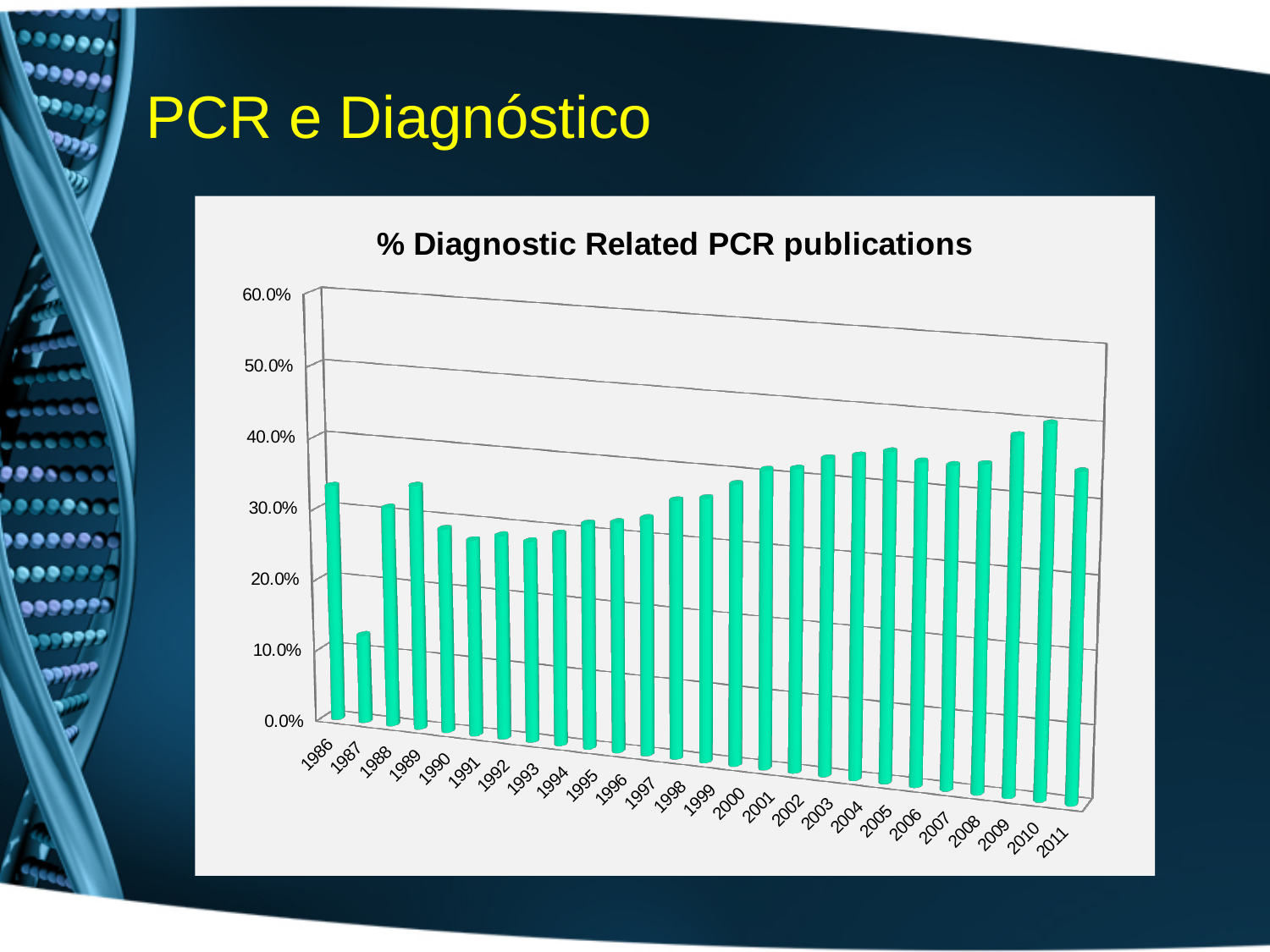
What is the title of the chart? % Diagnostic Related PCR publications Is the value for 2005 greater or less than 30.0%? greater Do the values generally rise or fall from 1991 to 2005? rise Which year has the lowest value in the chart? 1987 Which year has the larger value, 1991 or 2005? 2005 How many years are plotted on the x axis of the chart? 26 Is the value for 1991 greater or less than 30.0%? less Which year has the highest value in the chart? 2010 Is the value for 2010 greater or less than 30.0%? greater Which year has the larger value, 1986 or 1987? 1986 What kind of chart is shown on the slide? bar chart